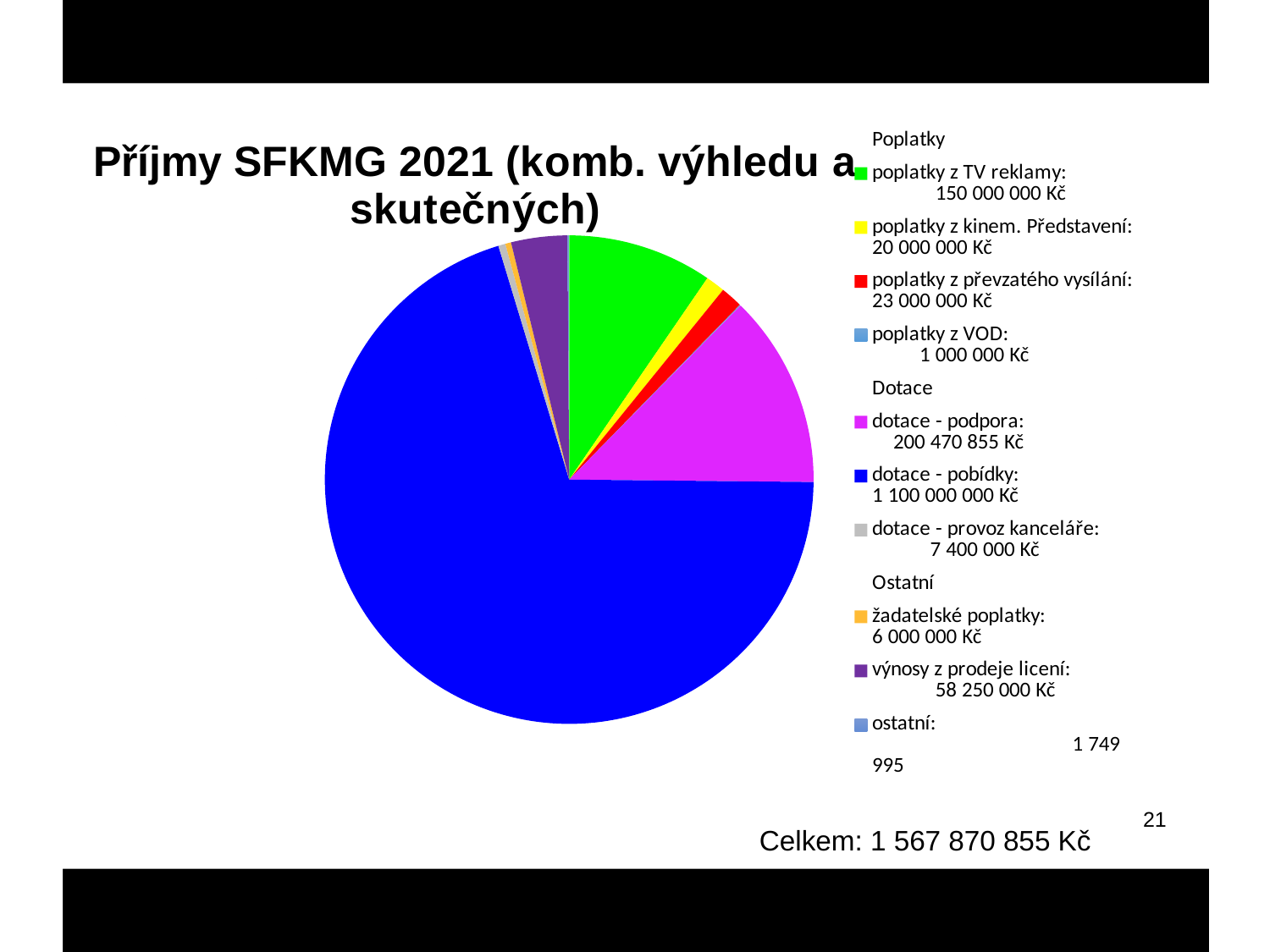
What is the difference between dotace - pobídky and dotace - podpora? 899 529 145 Kč How many slices does the pie chart have? 10 What kind of chart is shown on the slide? pie chart What is the value for poplatky z TV reklamy? 150 000 000 Kč What is the value for dotace - podpora? 200 470 855 Kč What is the value for výnosy z prodeje licení? 58 250 000 Kč Which category has the largest slice of the pie? dotace - pobídky What is the difference between poplatky z TV reklamy and poplatky z kinem. Představení? 130 000 000 Kč What is the value for dotace - pobídky? 1 100 000 000 Kč Which is larger, poplatky z převzatého vysílání or poplatky z kinem. Představení? poplatky z převzatého vysílání Which category has the smallest value in the legend? poplatky z VOD What total (Celkem) is printed below the chart? 1 567 870 855 Kč